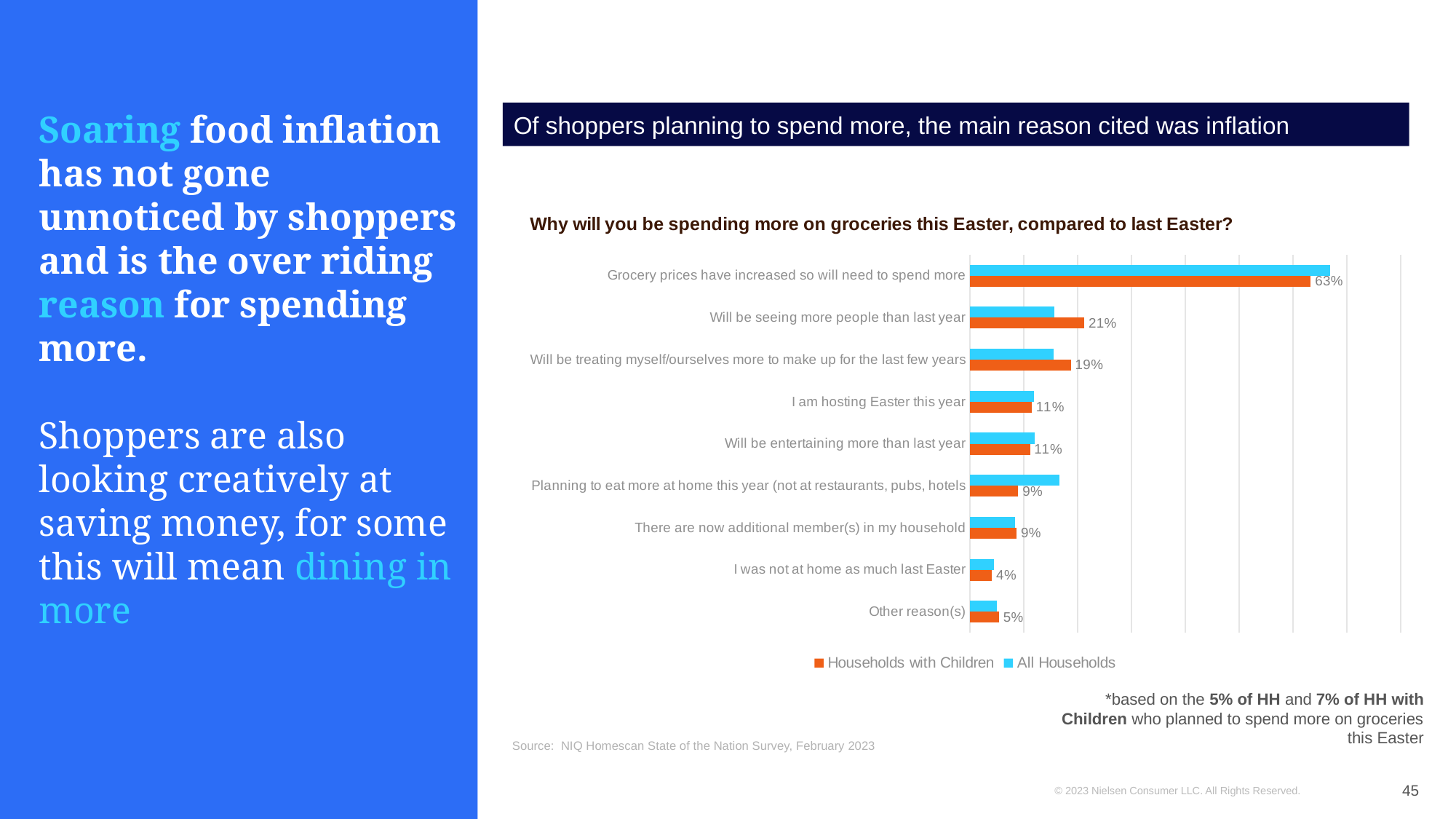
For 'Planning to eat more at home this year', which series has the larger value: Households with Children or All Households? All Households What percentage of Households with Children cited 'Grocery prices have increased so will need to spend more'? 63% What is the difference between the Households with Children values for 'Will be seeing more people than last year' and 'I am hosting Easter this year'? 10% How many series does the chart legend list? 2 What is the Households with Children value for 'I was not at home as much last Easter'? 4% What is the title of the chart? Why will you be spending more on groceries this Easter, compared to last Easter? Which reason has the lowest value for Households with Children? I was not at home as much last Easter What kind of chart is shown on the slide? bar chart How many reasons (categories) are plotted in the chart? 9 What is the Households with Children value for 'Will be treating myself/ourselves more to make up for the last few years'? 19% Which reason has the highest value for Households with Children? Grocery prices have increased so will need to spend more What is the Households with Children value for 'Will be seeing more people than last year'? 21%